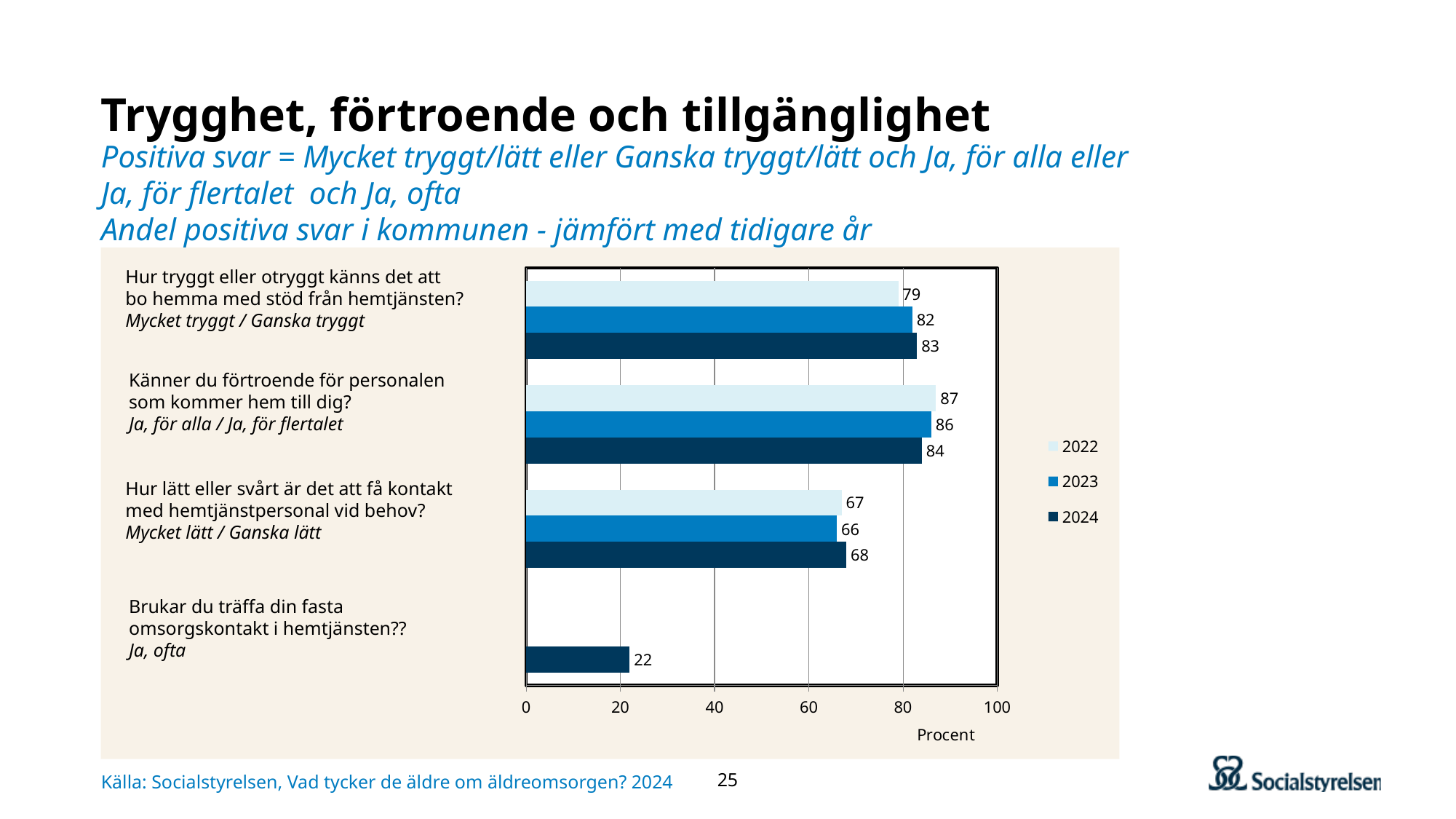
Which question has the lowest 2024 value? Brukar du träffa din fasta omsorgskontakt i hemtjänsten? What is the label on the horizontal axis of the chart? Procent What is the difference between the 2024 and 2022 values for "Hur tryggt eller otryggt känns det att bo hemma med stöd från hemtjänsten?"? 4 How many question categories are shown on the chart? 4 What is the 2024 value for "Brukar du träffa din fasta omsorgskontakt i hemtjänsten?"? 22 What is the 2023 value for "Hur lätt eller svårt är det att få kontakt med hemtjänstpersonal vid behov?"? 66 What kind of chart is shown on the slide? Bar chart How many series does the legend list? 3 What is the 2022 value for "Känner du förtroende för personalen som kommer hem till dig?"? 87 Which question has the highest 2022 value? Känner du förtroende för personalen som kommer hem till dig? What is the 2024 value for "Hur tryggt eller otryggt känns det att bo hemma med stöd från hemtjänsten?"? 83 For "Känner du förtroende för personalen som kommer hem till dig?", which year has the larger value, 2022 or 2024? 2022